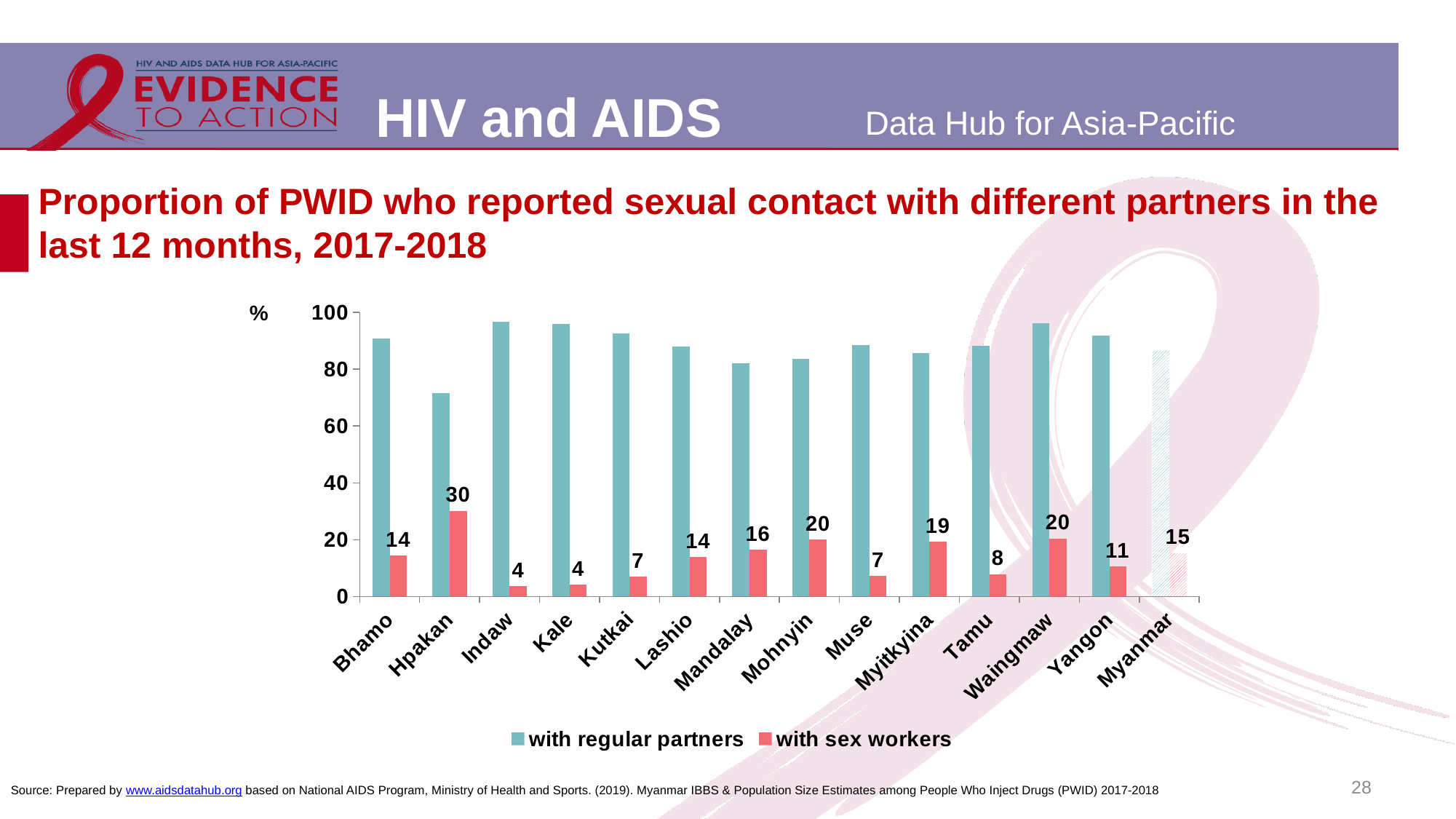
What is the value for Yangon in the 'with sex workers' series? 11 Is the 'with regular partners' value for Indaw greater or less than 80? greater What is the difference between the 'with sex workers' values for Hpakan and Yangon? 19 Which site has the highest proportion of PWID reporting sexual contact with sex workers? Hpakan What percentage of PWID in Hpakan reported sexual contact with sex workers? 30 How many series does the legend list? 2 Which series is shown in red in the legend? with sex workers What is the value for Myanmar in the 'with sex workers' series? 15 How many sites (categories) are shown on the x axis? 14 Which is larger, the 'with sex workers' value for Mohnyin or for Tamu? Mohnyin Is the 'with regular partners' value for Hpakan greater or less than 80? less What type of chart is shown on the slide? Bar chart